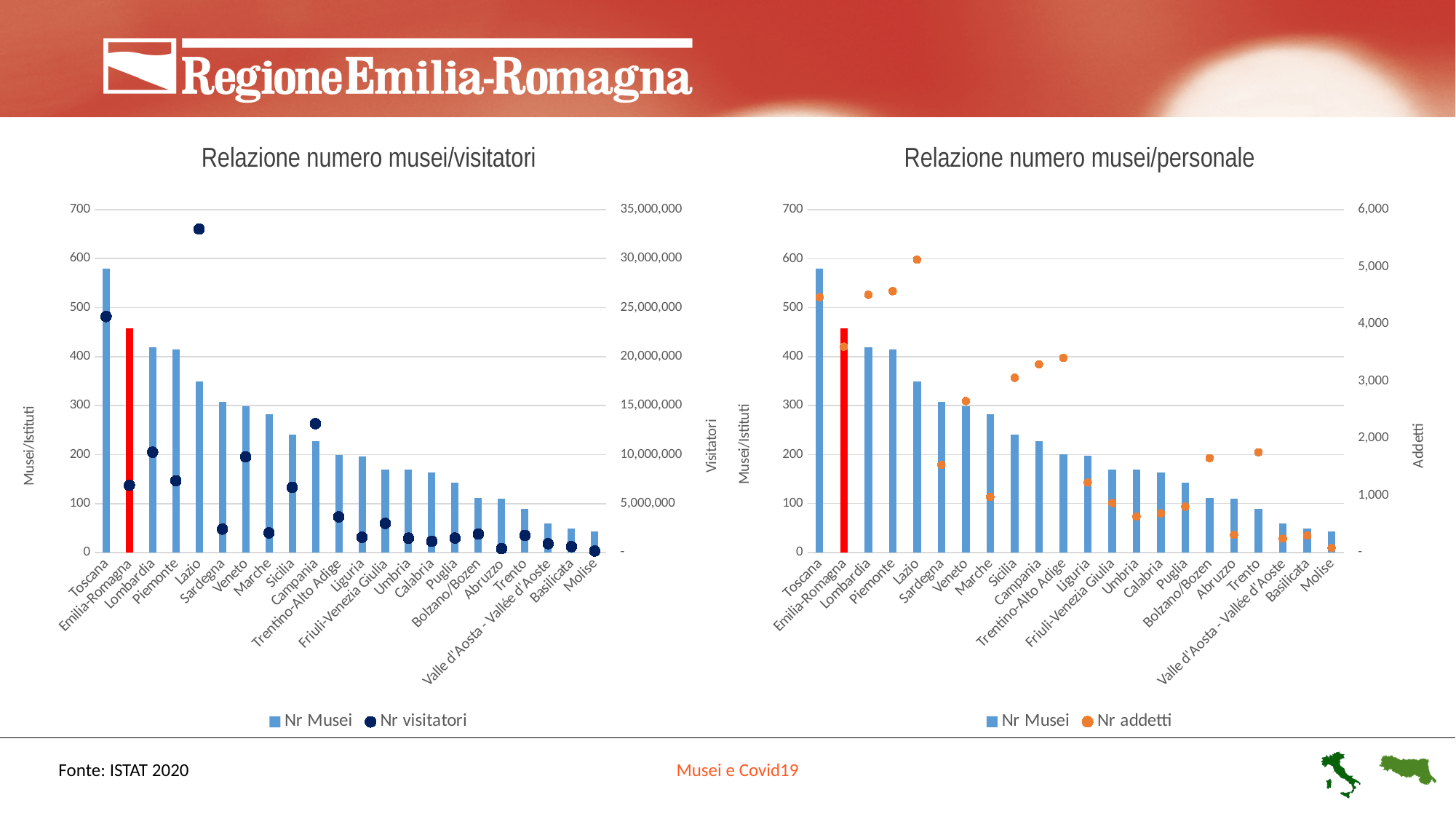
On the left chart 'Relazione numero musei/visitatori', which has more visitors (Nr visitatori), Campania or Sicilia? Campania On the right chart 'Relazione numero musei/personale', how many regions are shown on the x axis? 22 On the right chart 'Relazione numero musei/personale', which region has the lowest number of museums (Nr Musei)? Molise On the left chart 'Relazione numero musei/visitatori', which region has the highest number of museums (Nr Musei)? Toscana On the right chart 'Relazione numero musei/personale', which region has the highest number of staff (Nr addetti)? Lazio On the left chart 'Relazione numero musei/visitatori', is the Nr Musei value for Toscana greater or less than 500? greater On the left chart 'Relazione numero musei/visitatori', how many series does the legend list? 2 On the left chart 'Relazione numero musei/visitatori', is the Nr visitatori value for Lazio greater or less than 30,000,000? greater On the left chart 'Relazione numero musei/visitatori', what kind of chart is used for the Nr Musei series? bar chart On the right chart 'Relazione numero musei/personale', is the Nr addetti value for Emilia-Romagna greater or less than 3,000? greater On the left chart 'Relazione numero musei/visitatori', which region has the highest number of visitors (Nr visitatori)? Lazio On the right chart 'Relazione numero musei/personale', which region's Nr Musei bar is coloured red? Emilia-Romagna